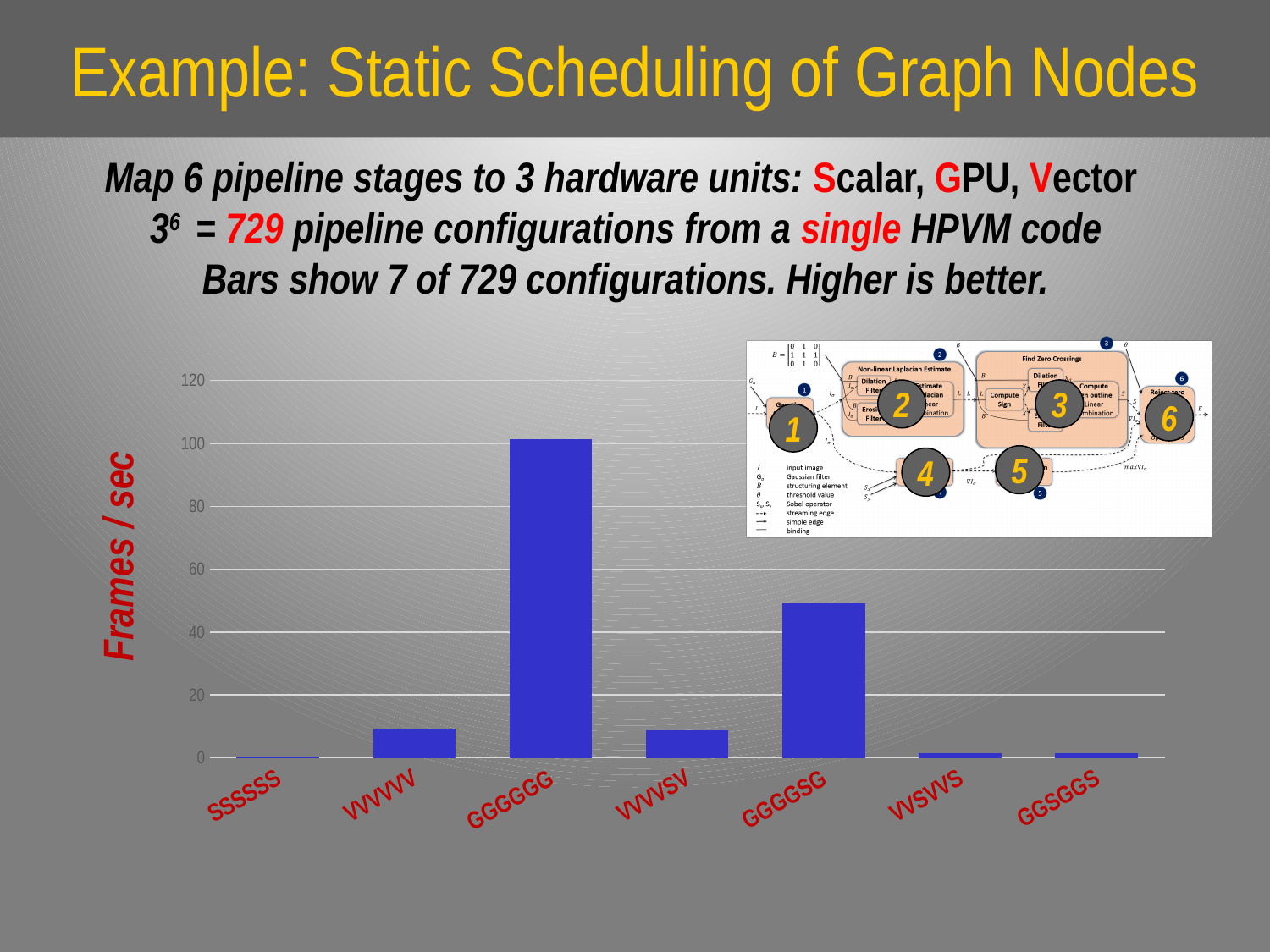
Which has a higher frames/sec value, VVVVVV or SSSSSS? VVVVVV Is the value for VVVVVV greater or less than 20 frames/sec? less How many pipeline configurations (bars) are plotted in the chart? 7 What is the label on the vertical axis of the chart? Frames / sec Is the value for GGGGGG greater or less than 80 frames/sec? greater Is the value for VVVVSV greater or less than 20 frames/sec? less Which configuration has the highest frames per second in the chart? GGGGGG What kind of chart is shown on the slide? bar chart Which has a higher frames/sec value, GGGGSG or VVVVSV? GGGGSG Which has a higher frames/sec value, GGGGGG or GGGGSG? GGGGGG